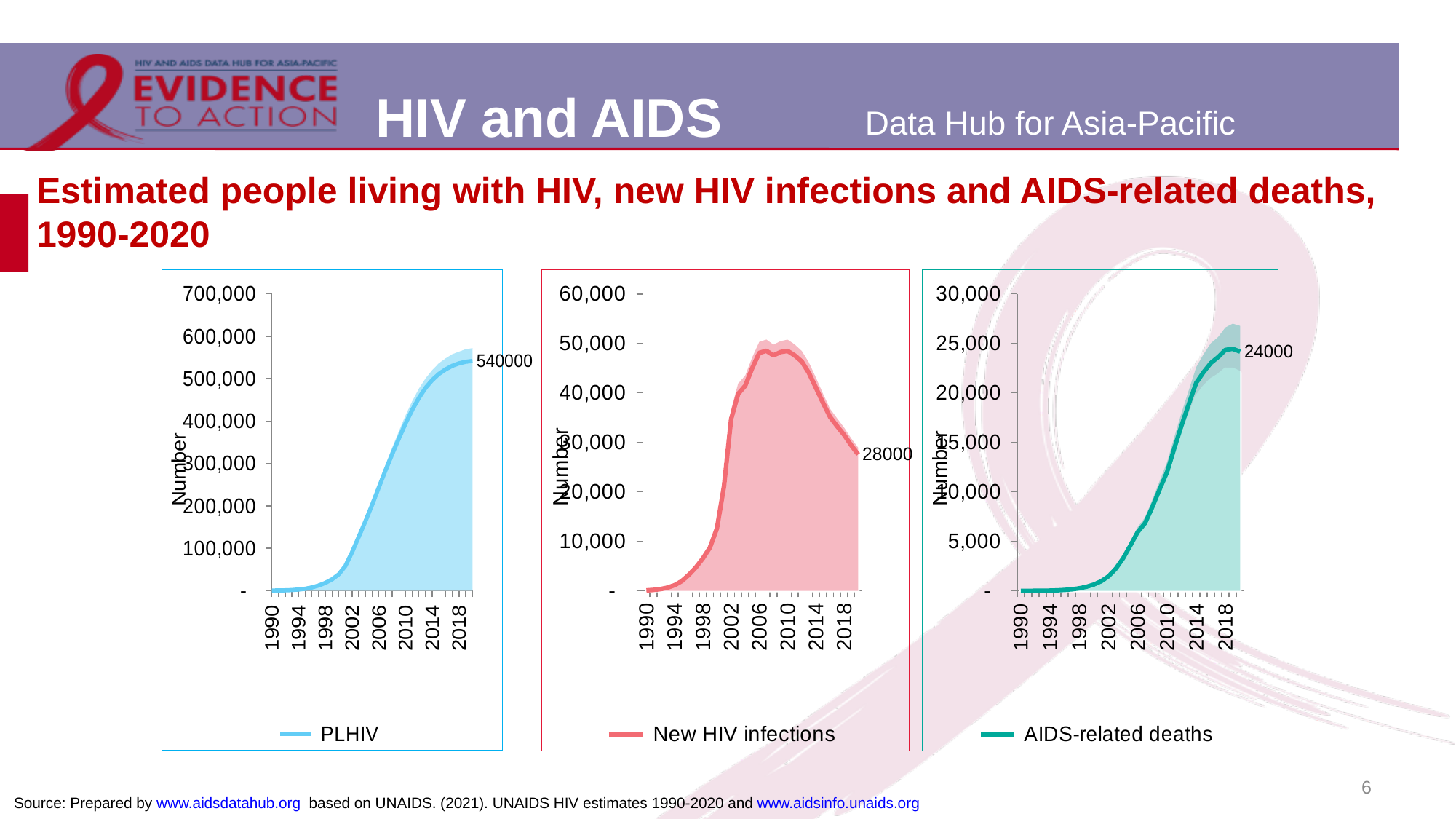
How many series does the legend of the New HIV infections chart list? 1 What is the difference between the 2020 labelled value on the New HIV infections chart and the 2020 labelled value on the AIDS-related deaths chart? 4000 What is the legend entry of the chart on the right? AIDS-related deaths On the New HIV infections chart, what value is labelled at the end of the line in 2020? 28000 On the PLHIV chart, do the values rise or fall from 1990 to 2020? Rise Which is larger in 2020: the labelled value on the New HIV infections chart or the labelled value on the AIDS-related deaths chart? New HIV infections On the PLHIV chart, what value is labelled at the end of the line in 2020? 540000 On the AIDS-related deaths chart, what value is labelled at the end of the line in 2020? 24000 On the New HIV infections chart, is the peak value around 2008 greater or less than 40,000? Greater On the New HIV infections chart, do the values rise or fall from 2010 to 2020? Fall What kind of chart is the PLHIV chart on the left? Combination area and line chart